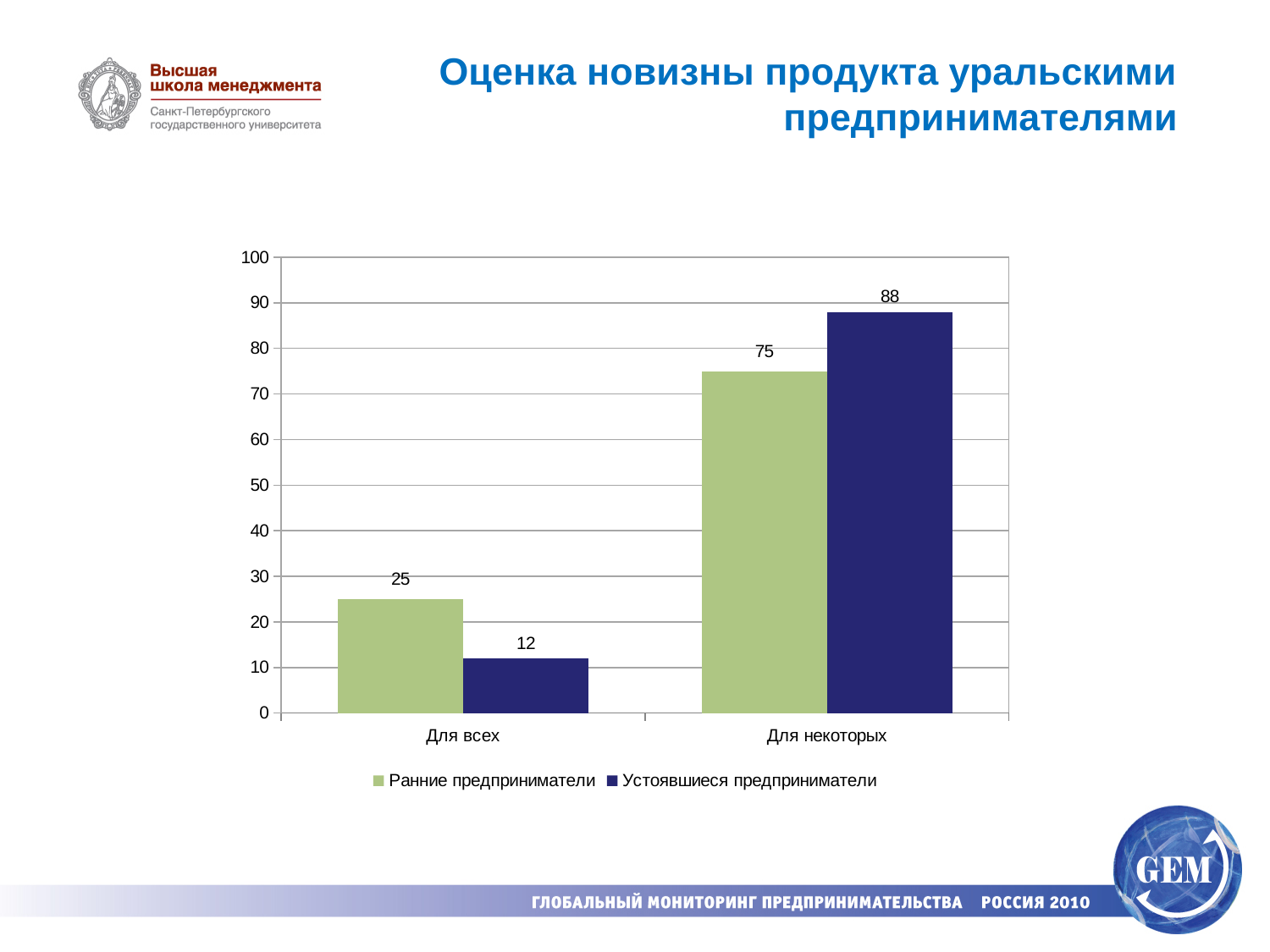
What is the value for Устоявшиеся предприниматели in the Для некоторых category? 88 What is the value for Ранние предприниматели in the Для всех category? 25 What colour are the bars for Устоявшиеся предприниматели? Dark blue What is the value for Устоявшиеся предприниматели in the Для всех category? 12 What is the value for Ранние предприниматели in the Для некоторых category? 75 How many categories are shown on the x axis? 2 Which category has the lowest value for Ранние предприниматели? Для всех What kind of chart is shown on the slide? Bar chart Which category has the highest value for Устоявшиеся предприниматели? Для некоторых How many series does the legend list? 2 What is the difference between the Устоявшиеся предприниматели and Ранние предприниматели values in the Для некоторых category? 13 In the Для всех category, which series has the larger value: Ранние предприниматели or Устоявшиеся предприниматели? Ранние предприниматели